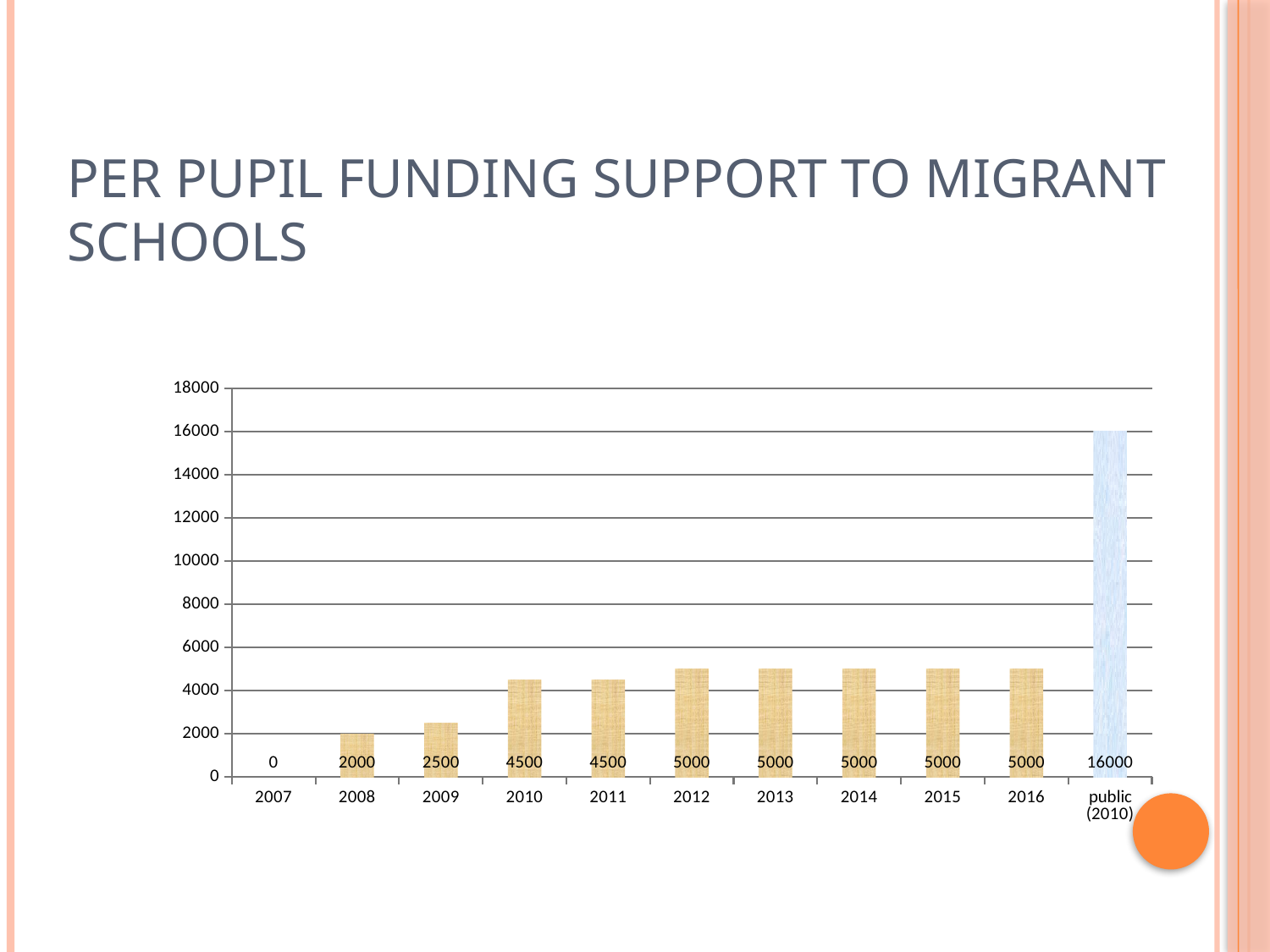
What is the value for 2007? 0 What is the value for 2010? 4500 What is the value for public (2010)? 16000 Which is larger, the value for 2009 or the value for 2012? 2012 Which category has the lowest value? 2007 How many categories are shown on the x axis? 11 What is the difference between the value for public (2010) and the value for 2016? 11000 What kind of chart is shown on the slide? bar chart What is the difference between the value for 2010 and the value for 2009? 2000 What is the value for 2008? 2000 Which category has the highest value? public (2010) Do the values rise or fall from 2007 to 2012? rise